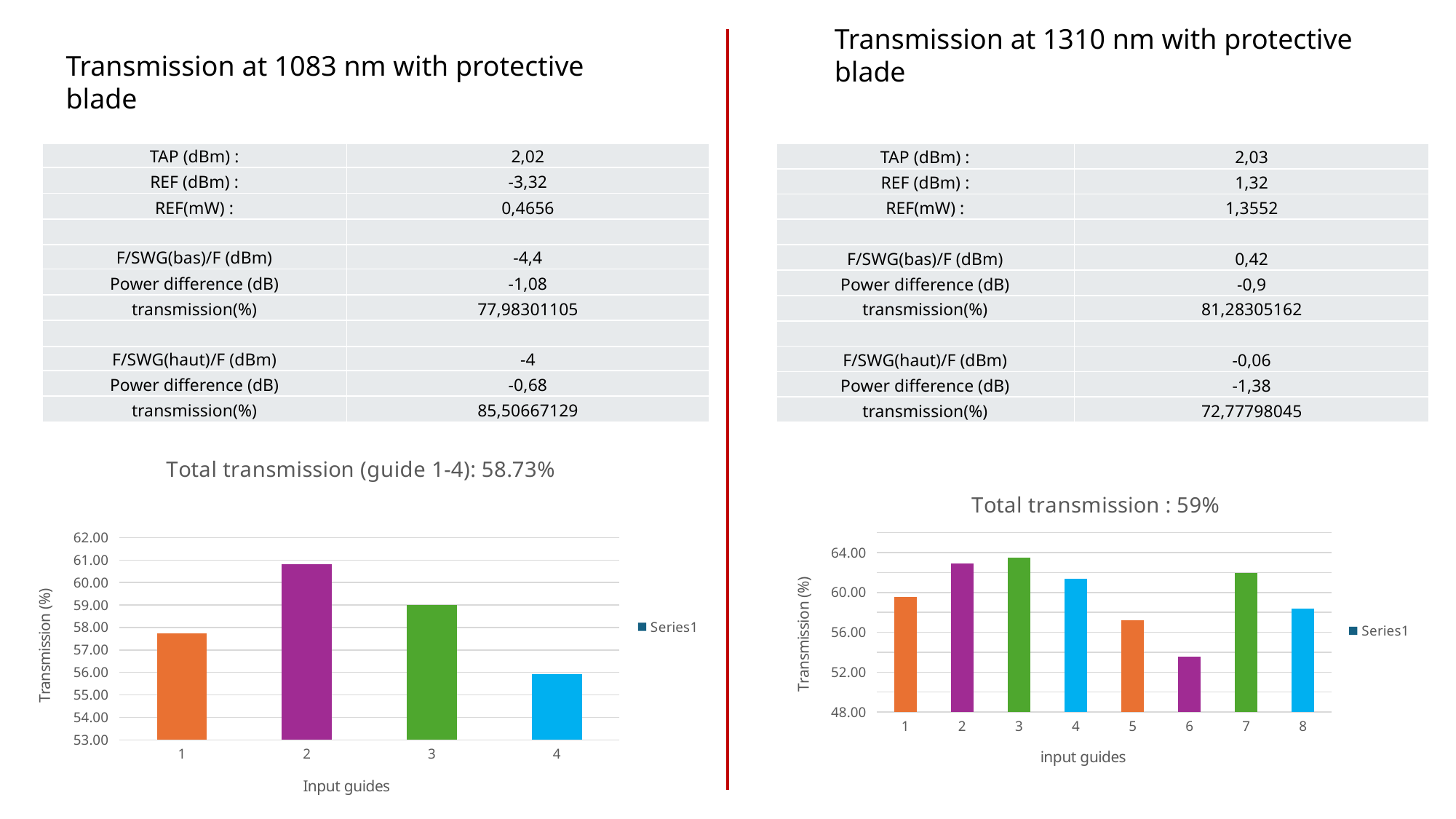
In the chart titled 'Total transmission (guide 1-4): 58.73%', which is larger, the value for input guide 3 or input guide 4? input guide 3 In the chart titled 'Total transmission (guide 1-4): 58.73%', which input guide has the highest transmission? 2 How many series does the legend of the chart titled 'Total transmission : 59%' list? 1 In the chart titled 'Total transmission (guide 1-4): 58.73%', is the value for input guide 1 greater or less than 58.00? less In the chart titled 'Total transmission : 59%', is the value for input guide 6 greater or less than 56.00? less In the chart titled 'Total transmission : 59%', which is larger, the value for input guide 7 or input guide 5? input guide 7 In the chart titled 'Total transmission : 59%', how many input guides are plotted? 8 In the chart titled 'Total transmission : 59%', which input guide has the lowest transmission? 6 In the chart titled 'Total transmission (guide 1-4): 58.73%', which input guide has the lowest transmission? 4 What kind of chart is the chart titled 'Total transmission (guide 1-4): 58.73%'? bar chart In the chart titled 'Total transmission (guide 1-4): 58.73%', is the value for input guide 2 greater or less than 60.00? greater In the chart titled 'Total transmission (guide 1-4): 58.73%', how many input guides are plotted? 4